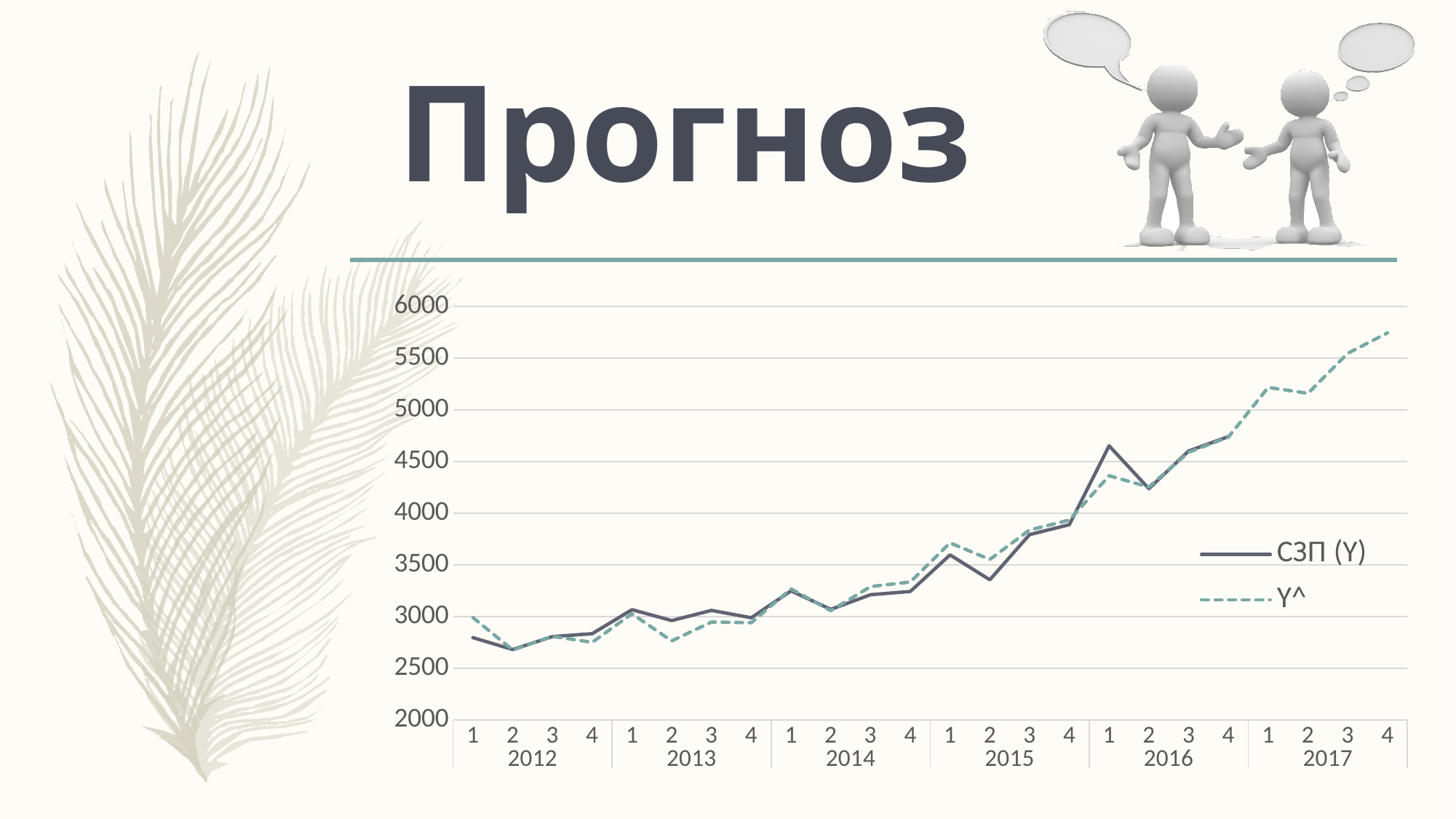
Is the value of СЗП (Y) in quarter 2 of 2015 greater or less than 3500? less How many series does the legend list? 2 Is the value of Y^ in quarter 4 of 2017 greater or less than 5500? greater Is the value of СЗП (Y) in quarter 1 of 2016 greater or less than 4500? greater What kind of chart is shown on the slide? line chart Which series is drawn with a dashed line? Y^ What are the two series named in the legend? СЗП (Y) and Y^ In quarter 1 of 2016, which series has the larger value, СЗП (Y) or Y^? СЗП (Y) Do the values generally rise or fall from 2012 to 2017? rise How many years are shown along the x axis? 6